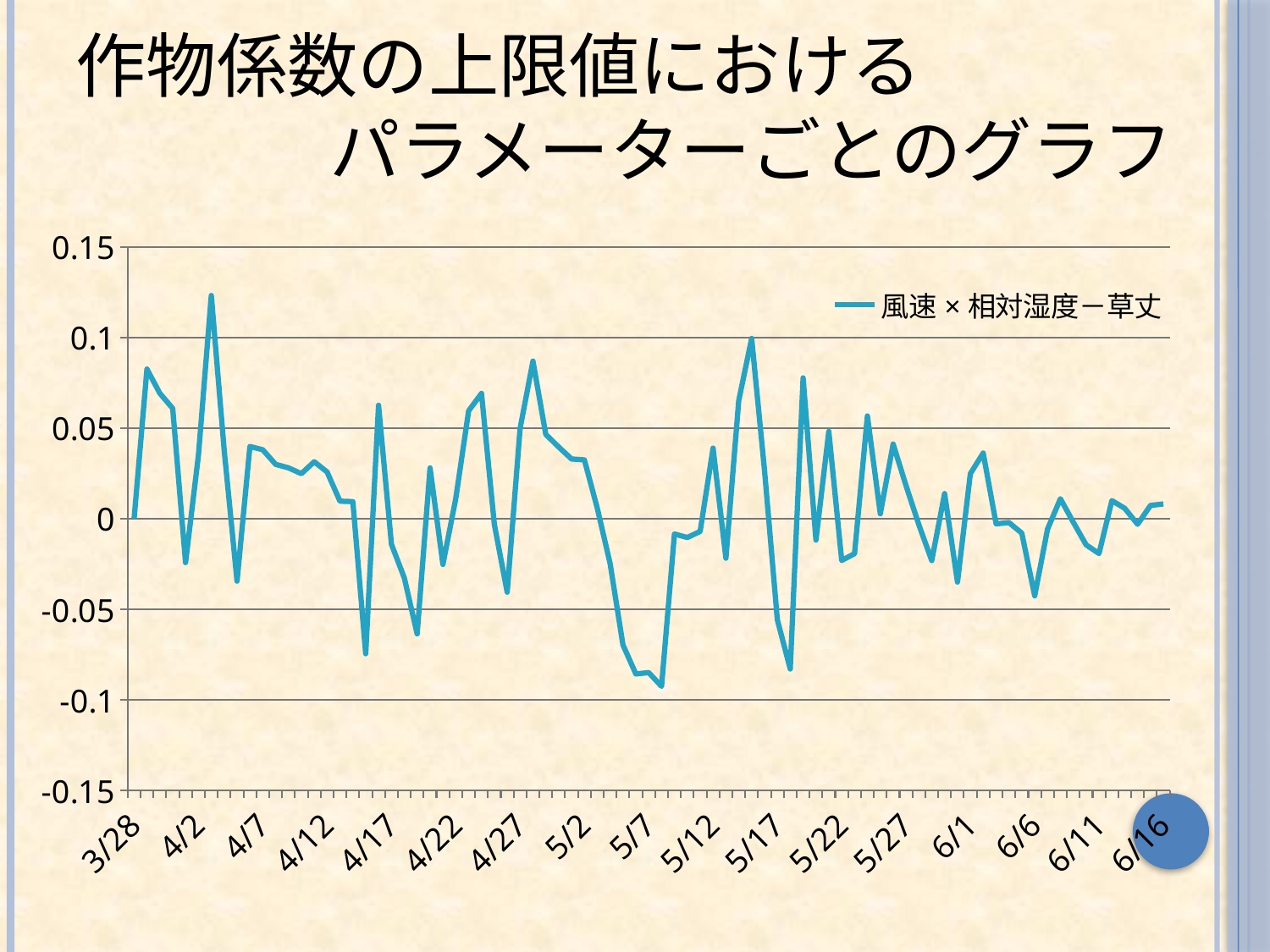
What is the name of the series shown in the legend? 風速 × 相対湿度－草丈 How many series does the legend list? 1 How many date labels are shown along the x axis? 17 What is the highest value shown on the y axis? 0.15 What is the last date label on the x axis? 6/16 Does the line ever drop below -0.1? No What is the first date label on the x axis? 3/28 What is the lowest value shown on the y axis? -0.15 Does the line ever rise above 0.15? No What kind of chart is shown on the slide? line chart Is the lowest point of the line greater or less than -0.05? less